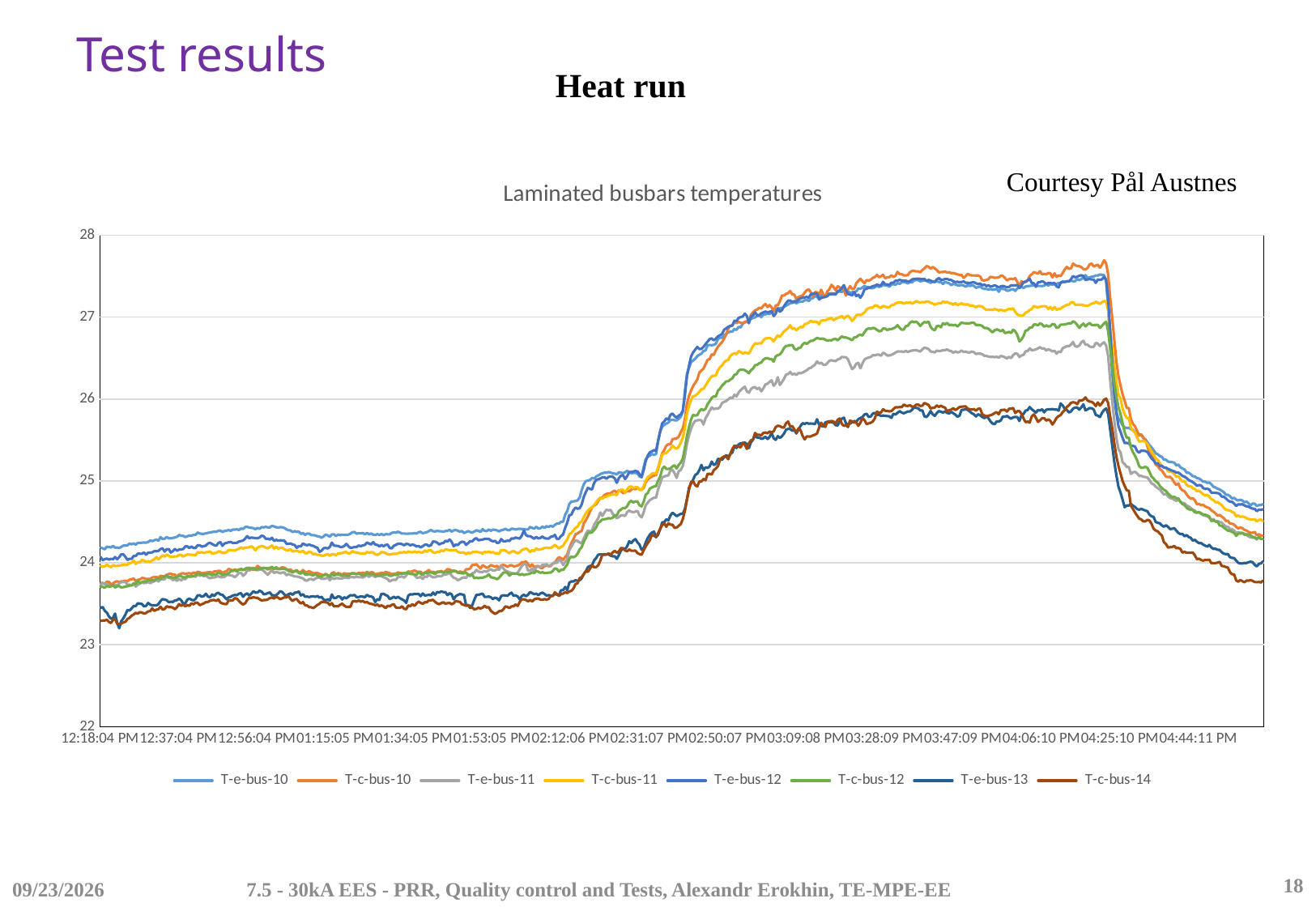
Do the temperatures rise or fall between 12:18:04 PM and 03:28:09 PM? rise Is the highest value reached by T-e-bus-11 greater or less than 27? less Is the highest value reached by T-c-bus-10 greater or less than 27? greater Which series is listed last in the chart legend? T-c-bus-14 Is the highest value reached by T-e-bus-11 greater or less than 26? greater What is the title of the chart? Laminated busbars temperatures How many time labels are shown on the x axis of the chart? 15 Do the temperatures rise or fall between 04:25:10 PM and 04:44:11 PM? fall What kind of chart is shown on the slide? line chart How many series does the legend of the chart list? 8